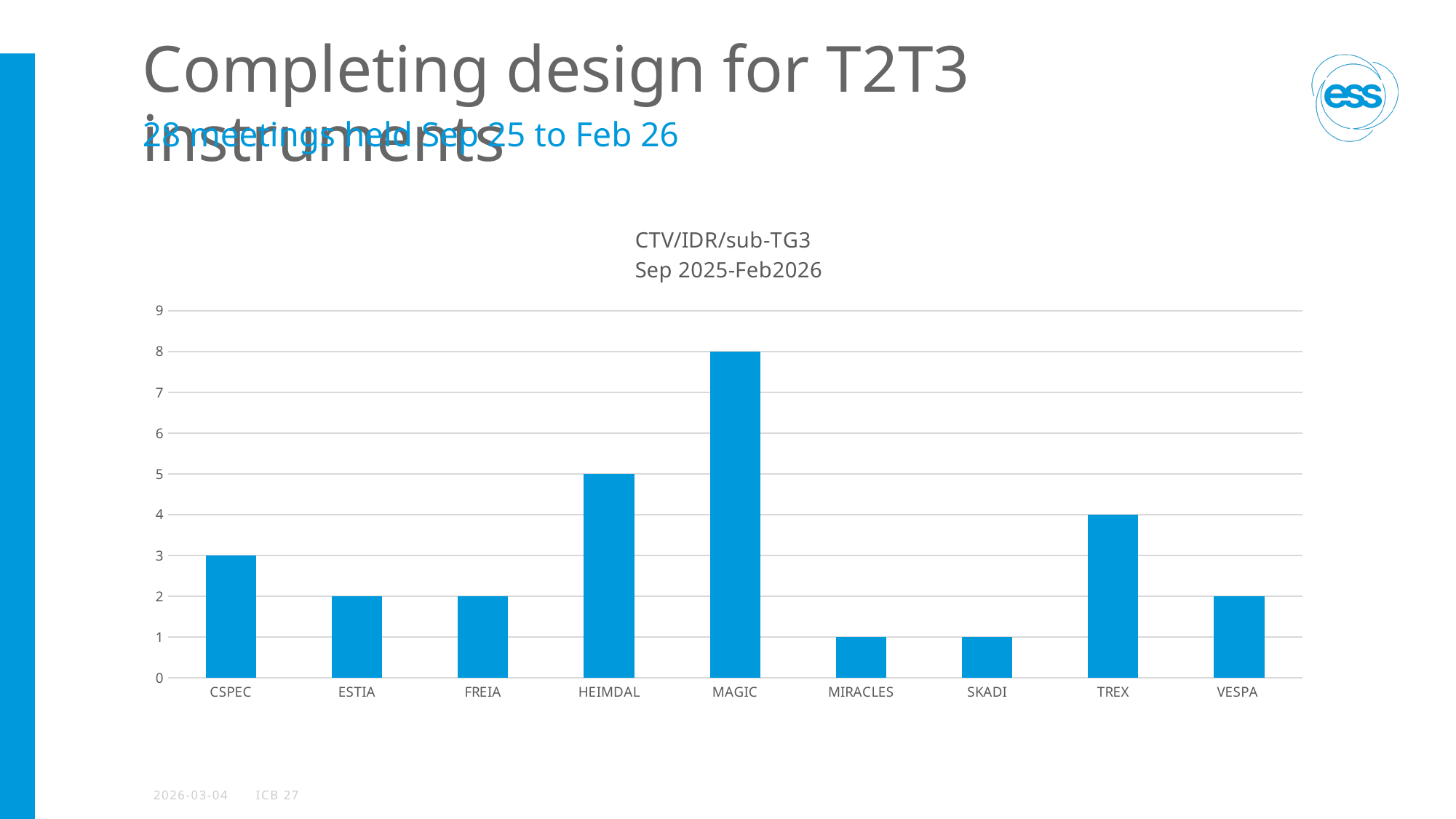
How many instruments (categories) are shown on the x axis? 9 Which instrument has the highest bar? MAGIC What kind of chart is shown on the slide? bar chart What is the value for MAGIC? 8 Is the value for HEIMDAL greater or less than 4? greater Which is larger, the value for TREX or the value for CSPEC? TREX What is the value for HEIMDAL? 5 What is the value for CSPEC? 3 Which instruments share the lowest value on the chart? MIRACLES and SKADI What is the difference between the values for MAGIC and HEIMDAL? 3 What is the title of the chart? CTV/IDR/sub-TG3 Sep 2025-Feb2026 What is the value for TREX? 4